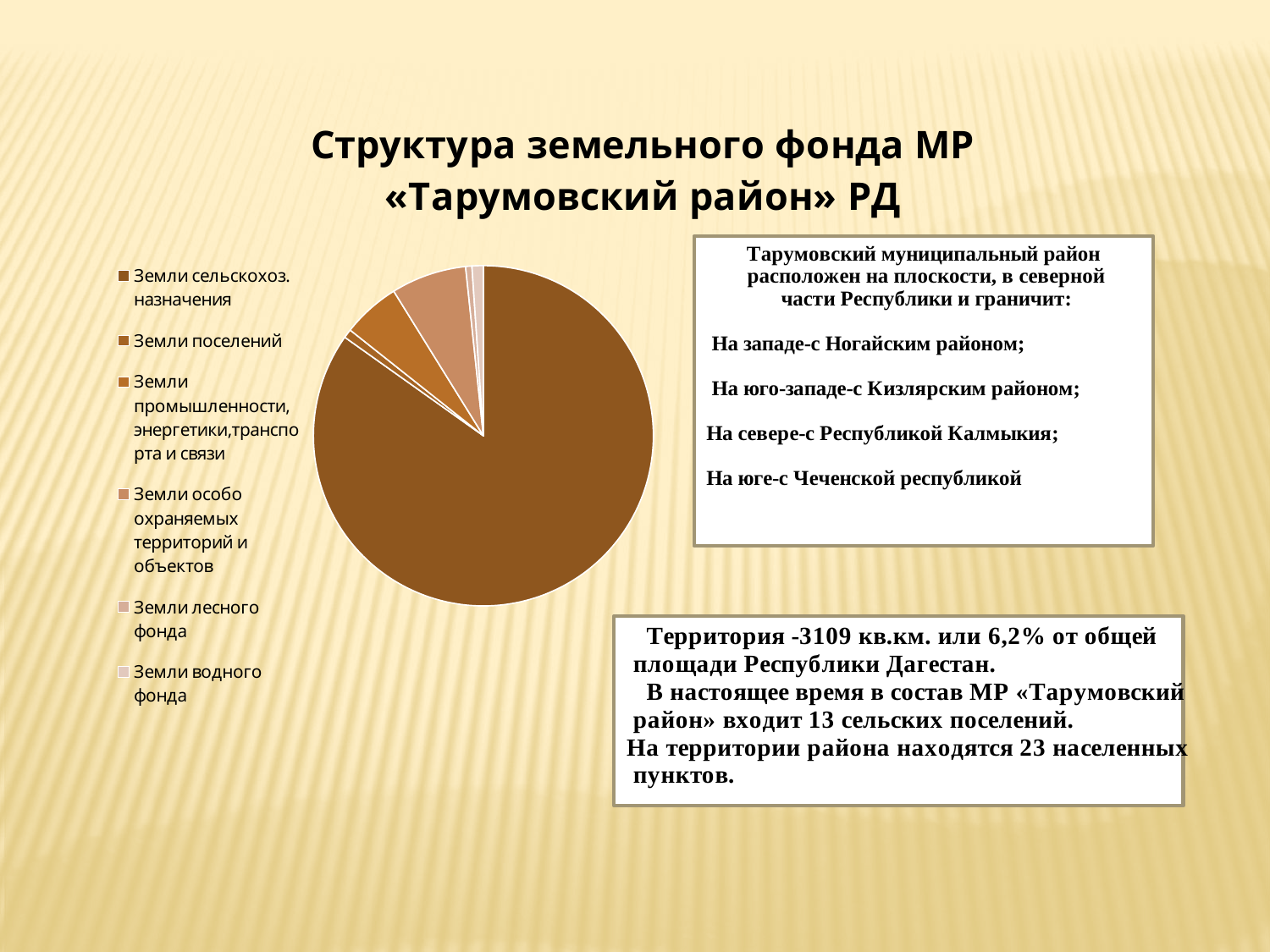
What is the last category listed in the pie chart's legend? Земли водного фонда Which is larger in the pie chart: Земли сельскохоз. назначения or Земли лесного фонда? Земли сельскохоз. назначения What kind of chart is shown on the slide? pie chart Which is larger in the pie chart: Земли сельскохоз. назначения or Земли промышленности, энергетики, транспорта и связи? Земли сельскохоз. назначения Does the largest slice of the pie chart take up more or less than half of the pie? more How many categories does the pie chart's legend list? 6 What is the title of the slide containing the pie chart? Структура земельного фонда МР «Тарумовский район» РД Which category has the largest slice of the pie chart? Земли сельскохоз. назначения